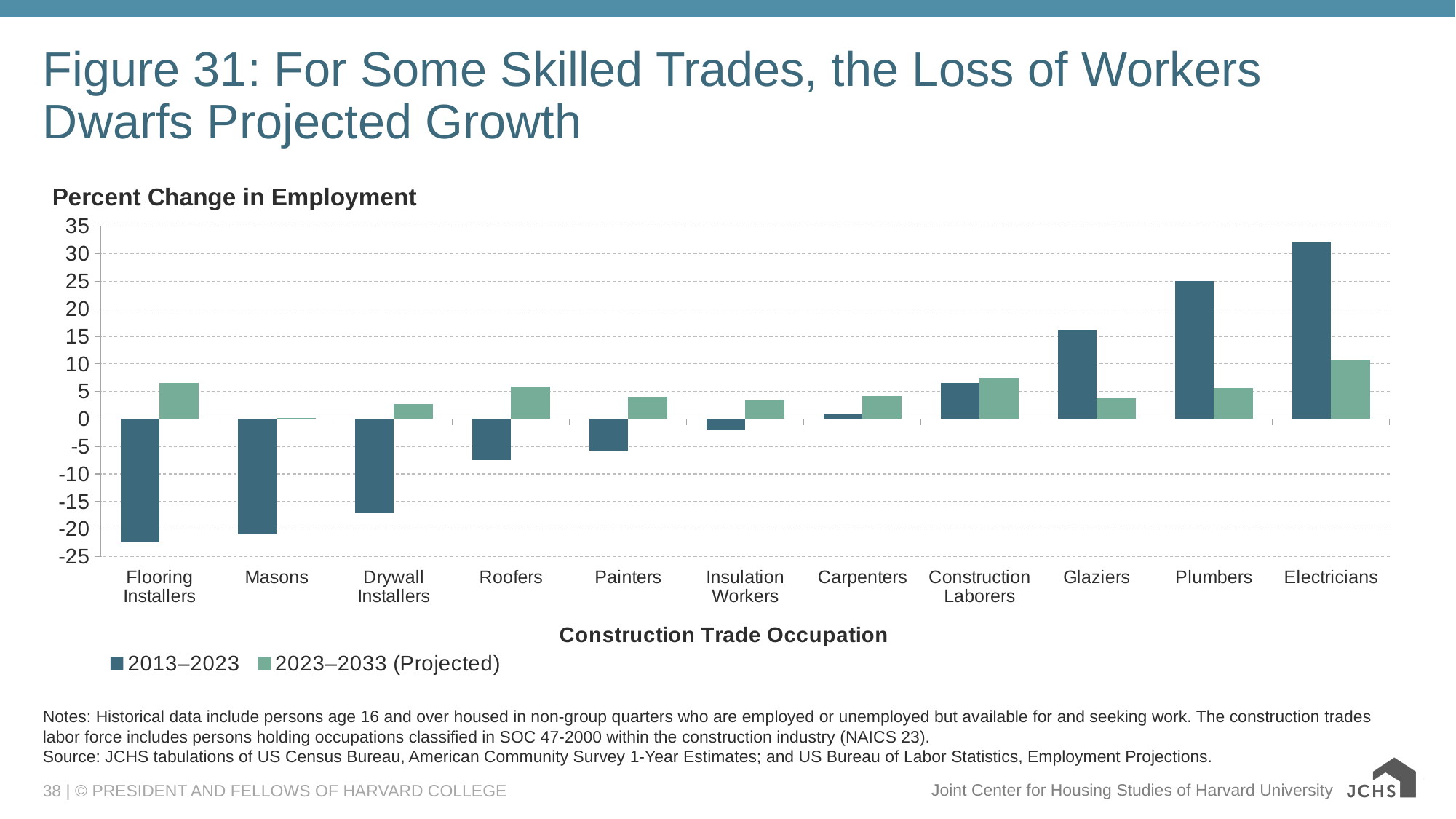
Which is larger for 2013–2023: the value for Plumbers or the value for Glaziers? Plumbers Which occupation has the lowest 2023–2033 (Projected) percent change in employment? Masons Which occupation has the highest 2023–2033 (Projected) percent change in employment? Electricians Is the 2013–2023 value for Drywall Installers greater or less than -15? less Which occupation has the highest 2013–2023 percent change in employment? Electricians Do the 2013–2023 values rise or fall moving from left to right across the occupations? rise What is the title of the y axis label above the chart? Percent Change in Employment How many series does the legend list? 2 How many construction trade occupations are shown on the x axis? 11 What kind of chart is shown on the slide? bar chart Is the 2013–2023 value for Flooring Installers greater or less than -20? less Is the 2013–2023 value for Electricians greater or less than 30? greater